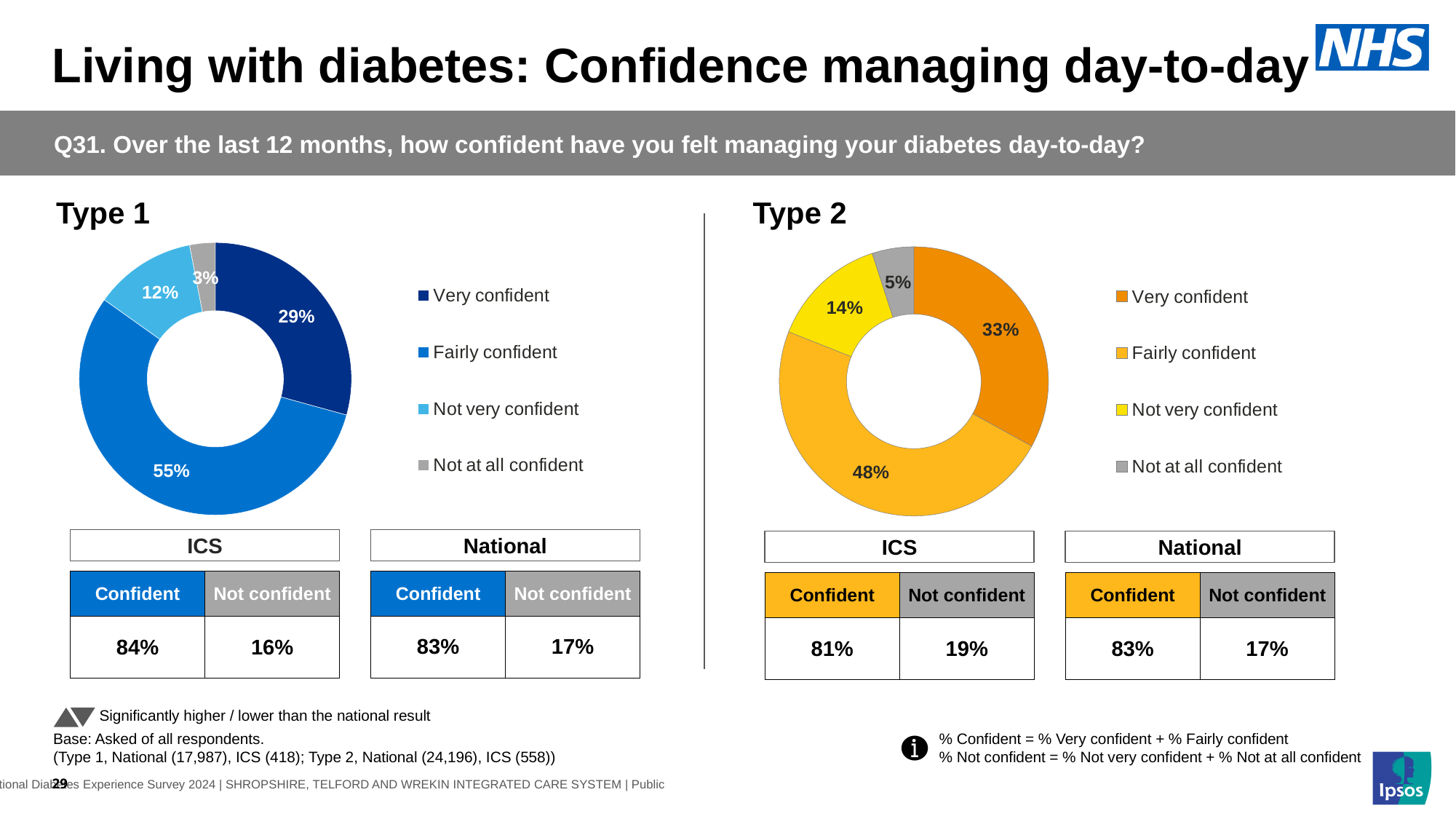
In the Type 2 chart, what percentage of respondents were Not at all confident? 5% In the Type 2 chart, what percentage of respondents were Not very confident? 14% In the Type 1 chart, what percentage of respondents were Very confident? 29% What colour represents Fairly confident in the Type 2 chart? Yellow-orange How many categories does the Type 1 chart show? 4 In the Type 1 chart, what is the combined share of Not very confident and Not at all confident? 15% What kind of chart is used for Type 2? Doughnut chart In the Type 2 chart, which category has the smallest share? Not at all confident In the Type 2 chart, what is the difference between the Fairly confident and Very confident shares? 15% In the Type 1 chart, which category has the largest share? Fairly confident In the Type 1 chart, what percentage of respondents were Fairly confident? 55% Which is larger: the Very confident share in the Type 1 chart or the Very confident share in the Type 2 chart? Type 2